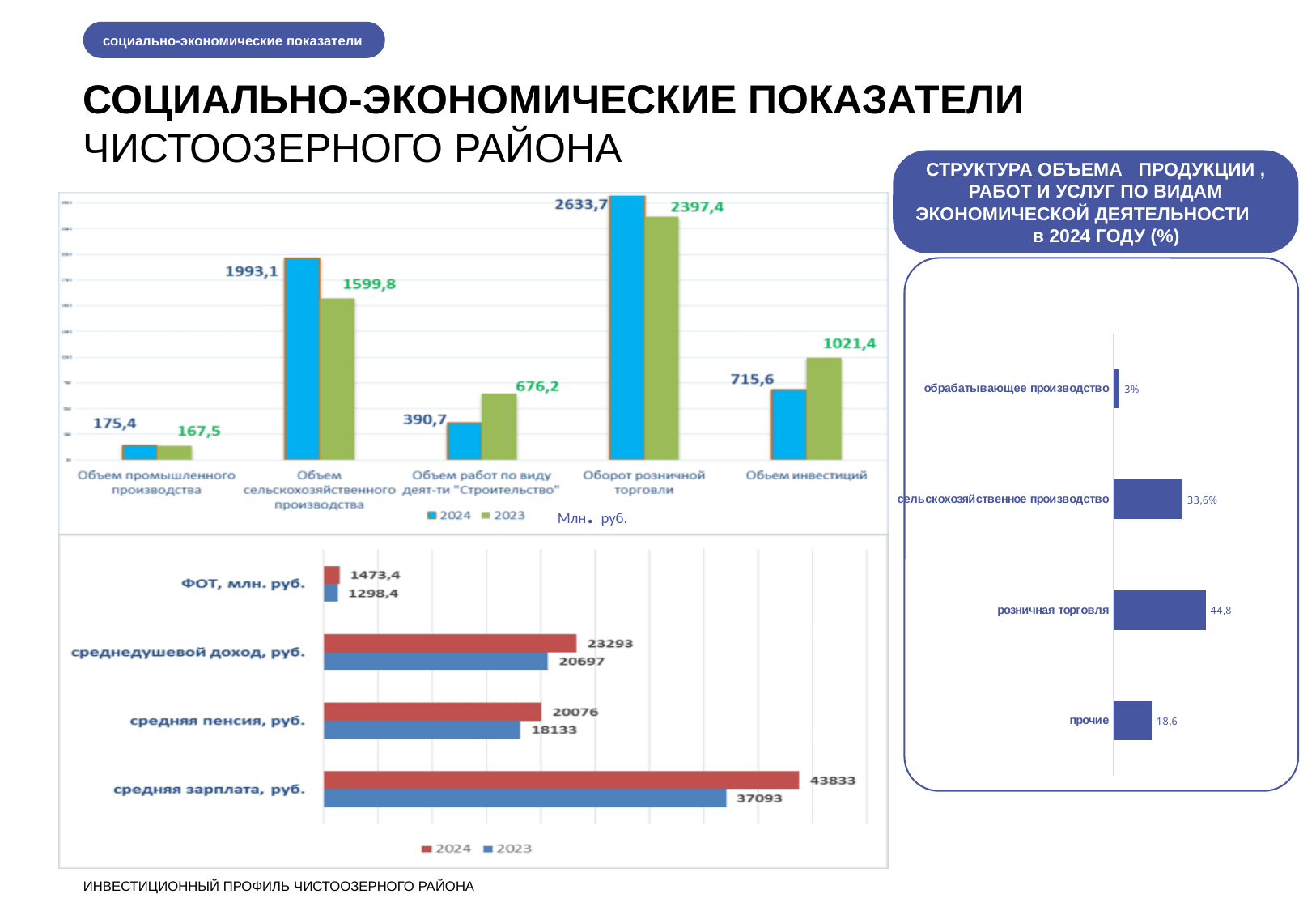
In the top-left bar chart, which is larger for Объем работ по виду деят-ти "Строительство": the 2024 value or the 2023 value? 2023 In the bottom-left bar chart, what is the 2024 value for средняя зарплата, руб.? 43833 In the top-left bar chart, what is the 2024 value for Оборот розничной торговли? 2633,7 In the top-left bar chart, which category has the lowest 2023 value? Объем промышленного производства In the bottom-left bar chart, what is the 2023 value for средняя пенсия, руб.? 18133 In the top-left bar chart, what is the 2023 value for Объем инвестиций? 1021,4 In the chart on the right (Структура объема продукции, работ и услуг в 2024 году), which category has the highest share? розничная торговля In the bottom-left bar chart, what is the difference between the 2024 and 2023 values for среднедушевой доход, руб.? 2596 In the chart on the right (Структура объема продукции, работ и услуг в 2024 году), what is the value for сельскохозяйственное производство? 33,6% In the top-left bar chart, what is the difference between the 2024 and 2023 values for Объем сельскохозяйственного производства? 393,3 How many categories are shown in the top-left bar chart? 5 In the top-left bar chart, which category has the highest 2024 value? Оборот розничной торговли